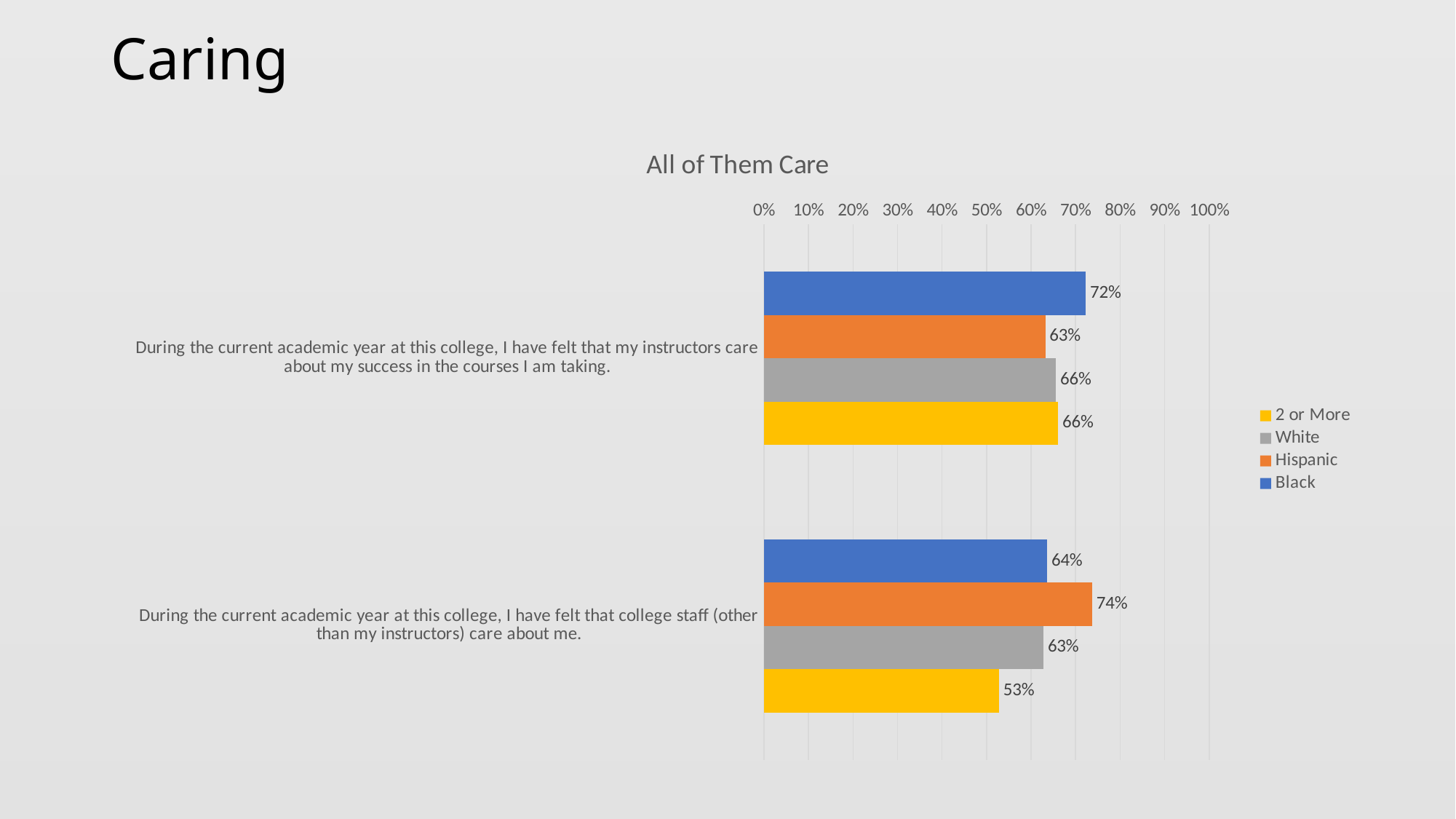
Is the value for Black on the statement about college staff caring about me greater or less than 50%? greater How many series does the legend list? 4 What kind of chart is shown on the slide? Bar chart What is the difference between the Hispanic and 2 or More values on the statement about college staff caring about me? 21% What is the value for White on the statement about instructors caring about my success? 66% Which is larger on the statement about instructors caring about my success: the Black value or the Hispanic value? Black What is the value for Black on the statement about instructors caring about my success? 72% Which group has the lowest value on the statement about college staff (other than my instructors) caring about me? 2 or More What is the value for Hispanic on the statement about college staff (other than my instructors) caring about me? 74% Which group has the highest value on the statement about instructors caring about my success? Black What is the title of the chart? All of Them Care What is the value for 2 or More on the statement about college staff (other than my instructors) caring about me? 53%